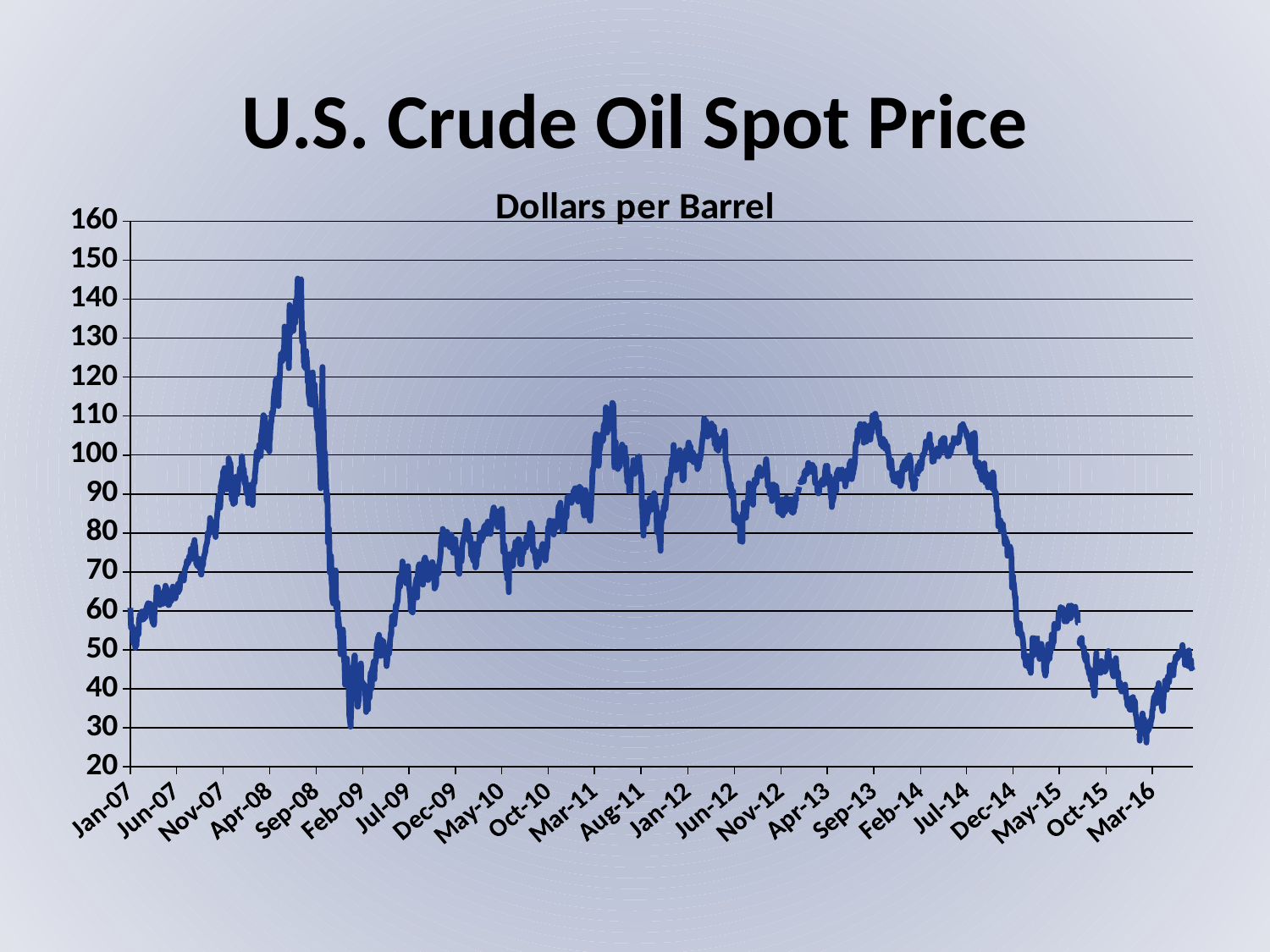
What is the title of the chart? U.S. Crude Oil Spot Price What unit is the price measured in, according to the chart subtitle? Dollars per Barrel Is the value for Jul-14 greater or less than 90? greater Is the value for Apr-13 greater or less than 70? greater Does the price rise or fall between Feb-09 and Mar-11? rise Is the value for Mar-16 greater or less than 60? less What kind of chart is shown on the slide? line chart Does the price rise or fall between Jul-14 and Dec-14? fall Which is larger, the value for Sep-13 or the value for May-15? Sep-13 In which year does the crude oil spot price reach its highest point? 2008